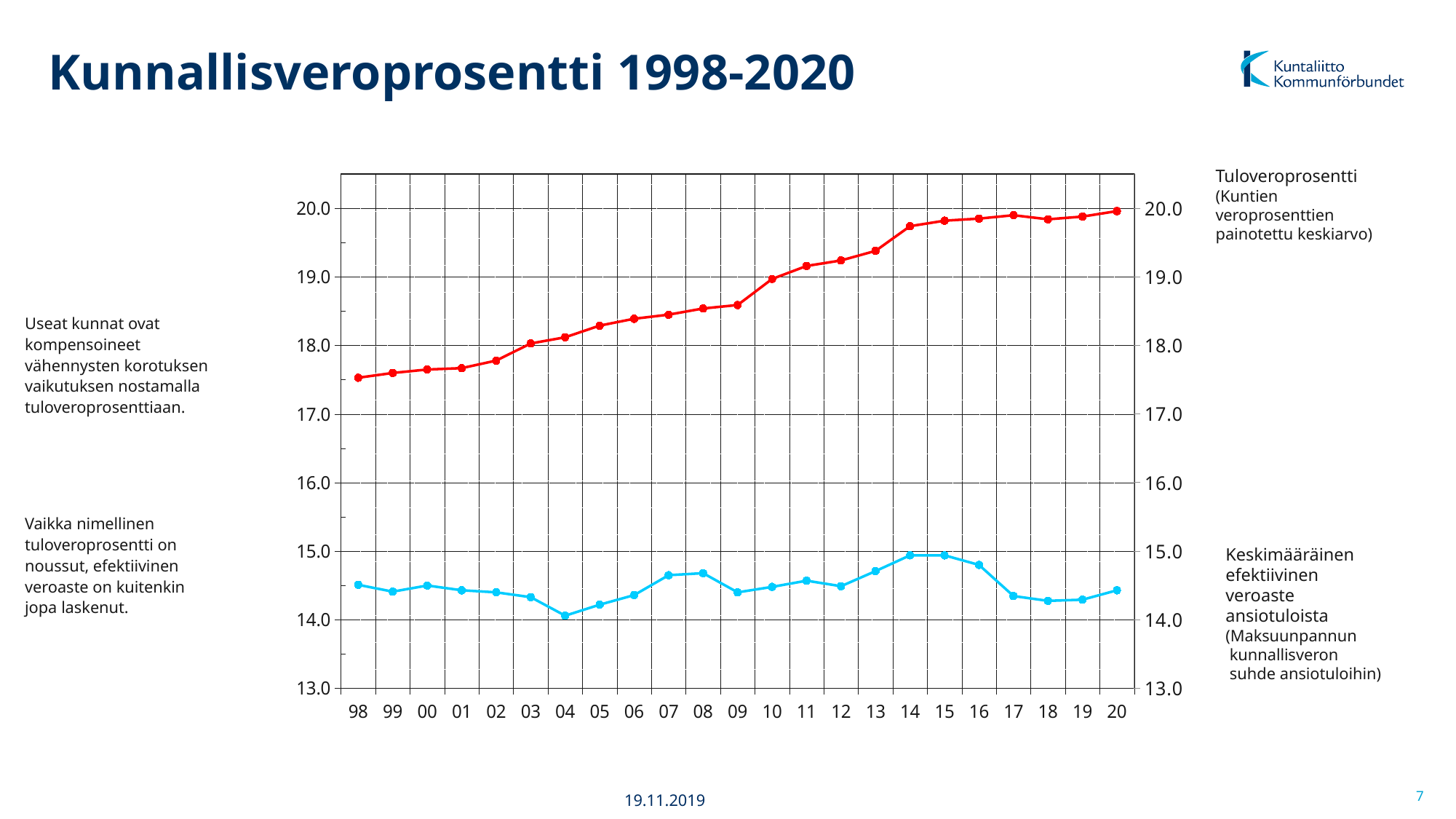
Is the Tuloveroprosentti value for 13 greater or less than 19.0? greater In which year is the Keskimääräinen efektiivinen veroaste (blue) line at its lowest? 04 Is the Tuloveroprosentti value for 98 greater or less than 18.0? less Is the Tuloveroprosentti value for 20 greater or less than 19.0? greater What colour is the Tuloveroprosentti line? Red How many data series are plotted on the chart? 2 What kind of chart is shown on the slide? Line chart In which year is the Tuloveroprosentti (red) line at its lowest? 98 How many years (data points per series) are plotted along the x axis? 23 Does the Tuloveroprosentti (red) line rise or fall from 98 to 20? Rises Which is larger in 10: the Tuloveroprosentti value or the Keskimääräinen efektiivinen veroaste value? Tuloveroprosentti